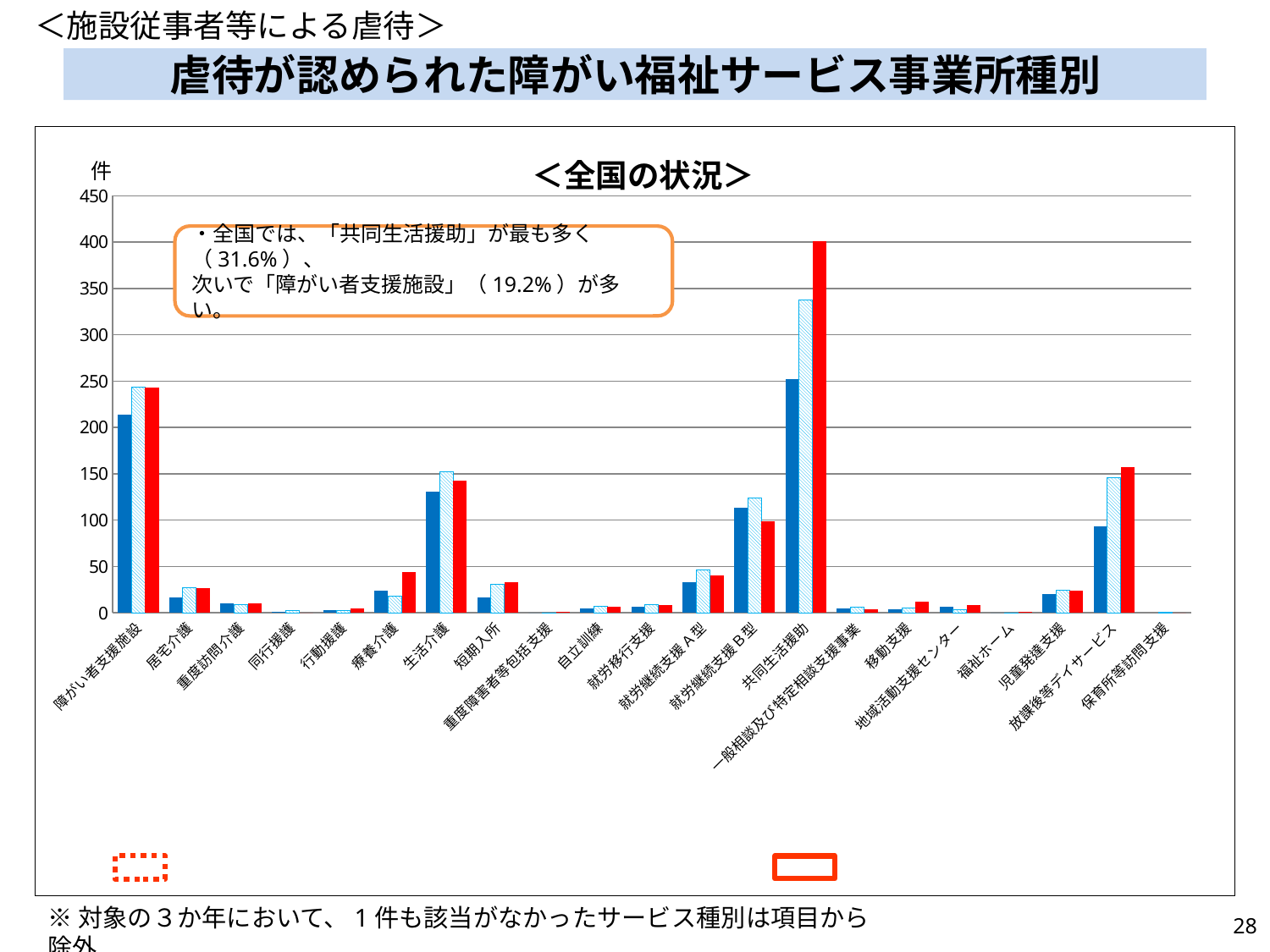
Is the value of the dark blue bar for 共同生活援助 greater or less than 200? greater How many service-type categories are shown along the x axis? 21 Which category has the tallest bars in the chart? 共同生活援助 What is the title printed above the chart's plot area? ＜全国の状況＞ Which has the larger red bar, 共同生活援助 or 障がい者支援施設? 共同生活援助 Is the value of the red bar for 生活介護 greater or less than 100? greater What kind of chart is shown on the slide? bar chart Is the value of the dark blue bar for 就労継続支援Ａ型 greater or less than 50? less What unit label is shown at the top of the vertical axis? 件